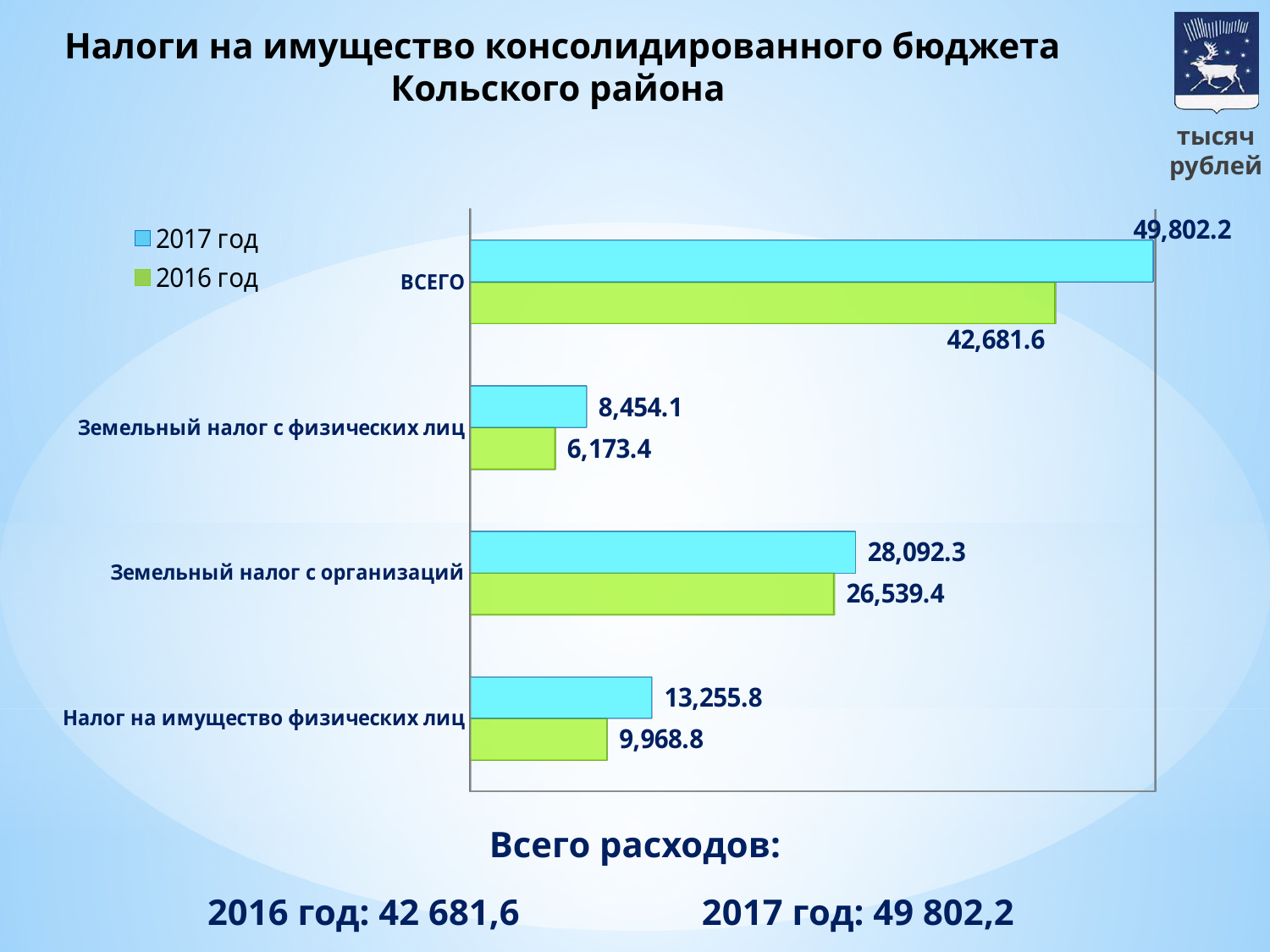
Which legend entry is shown in green? 2016 год Excluding ВСЕГО, which category has the highest value in 2017 год? Земельный налог с организаций What is the value for ВСЕГО in 2016 год? 42,681.6 What is the value for Налог на имущество физических лиц in 2016 год? 9,968.8 How many series does the legend list? 2 What type of chart is shown on the slide? bar chart What is the value for ВСЕГО in 2017 год? 49,802.2 What is the difference between the 2017 год and 2016 год values for Земельный налог с организаций? 1,552.9 What is the value for Земельный налог с физических лиц in 2017 год? 8,454.1 Which is larger for Налог на имущество физических лиц: the 2017 год value or the 2016 год value? 2017 год Excluding ВСЕГО, which category has the lowest value in 2016 год? Земельный налог с физических лиц How many categories are shown on the chart? 4